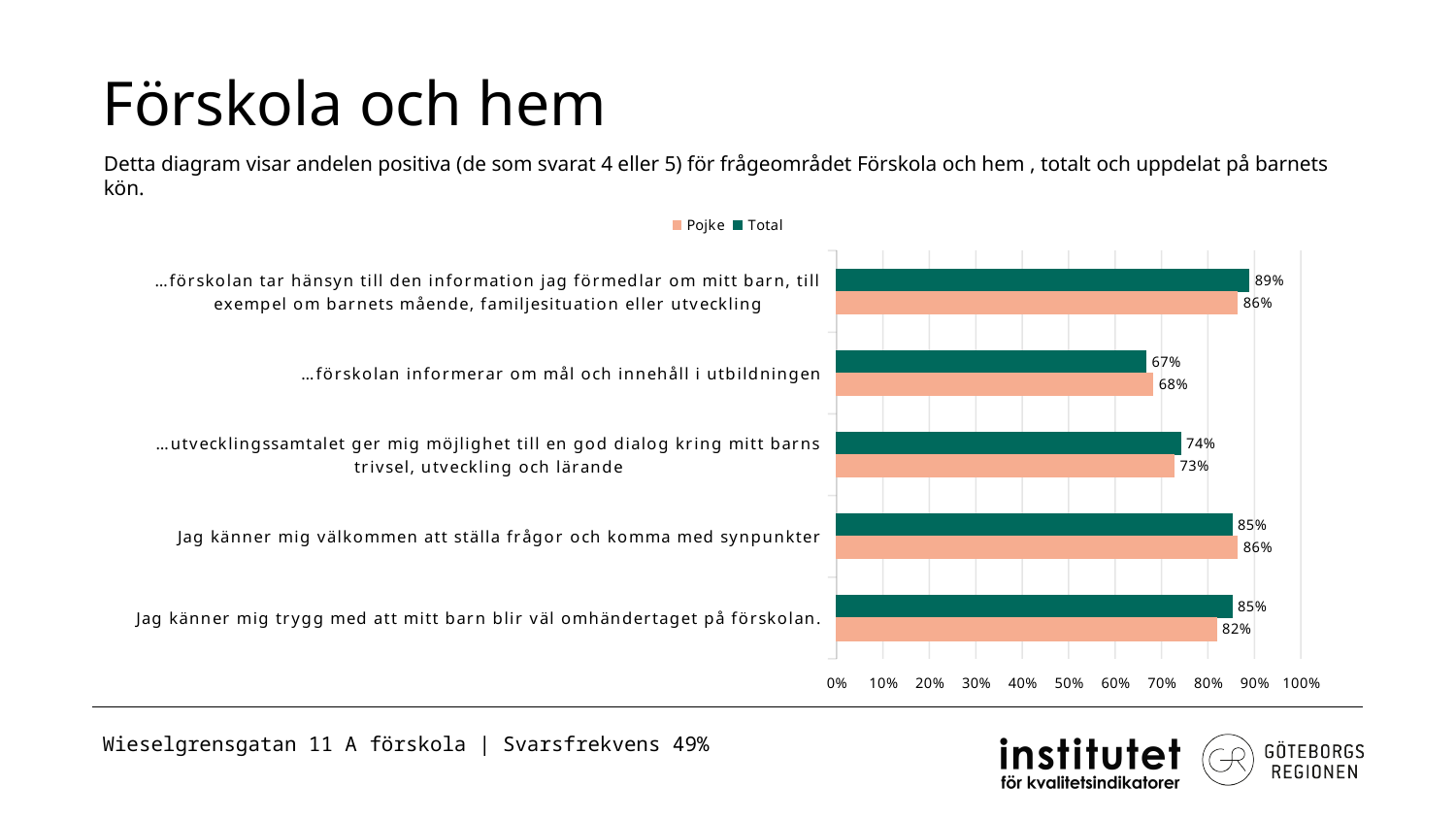
What is the Pojke value for "…förskolan informerar om mål och innehåll i utbildningen"? 68% Which statement has the highest Total value? …förskolan tar hänsyn till den information jag förmedlar om mitt barn, till exempel om barnets mående, familjesituation eller utveckling What is the Total value for "…förskolan tar hänsyn till den information jag förmedlar om mitt barn, till exempel om barnets mående, familjesituation eller utveckling"? 89% What is the Pojke value for "Jag känner mig trygg med att mitt barn blir väl omhändertaget på förskolan."? 82% What is the difference between the Total and Pojke values for "Jag känner mig trygg med att mitt barn blir väl omhändertaget på förskolan."? 3 percentage points What type of chart is shown on the slide? bar chart For "…utvecklingssamtalet ger mig möjlighet till en god dialog kring mitt barns trivsel, utveckling och lärande", which is larger, the Total value or the Pojke value? Total How many series does the legend list? 2 Which statement has the lowest Total value? …förskolan informerar om mål och innehåll i utbildningen Is the Total value for "…förskolan informerar om mål och innehåll i utbildningen" greater or less than 70%? less Which series is shown in dark green in the legend? Total How many categories (statements) are shown in the chart? 5